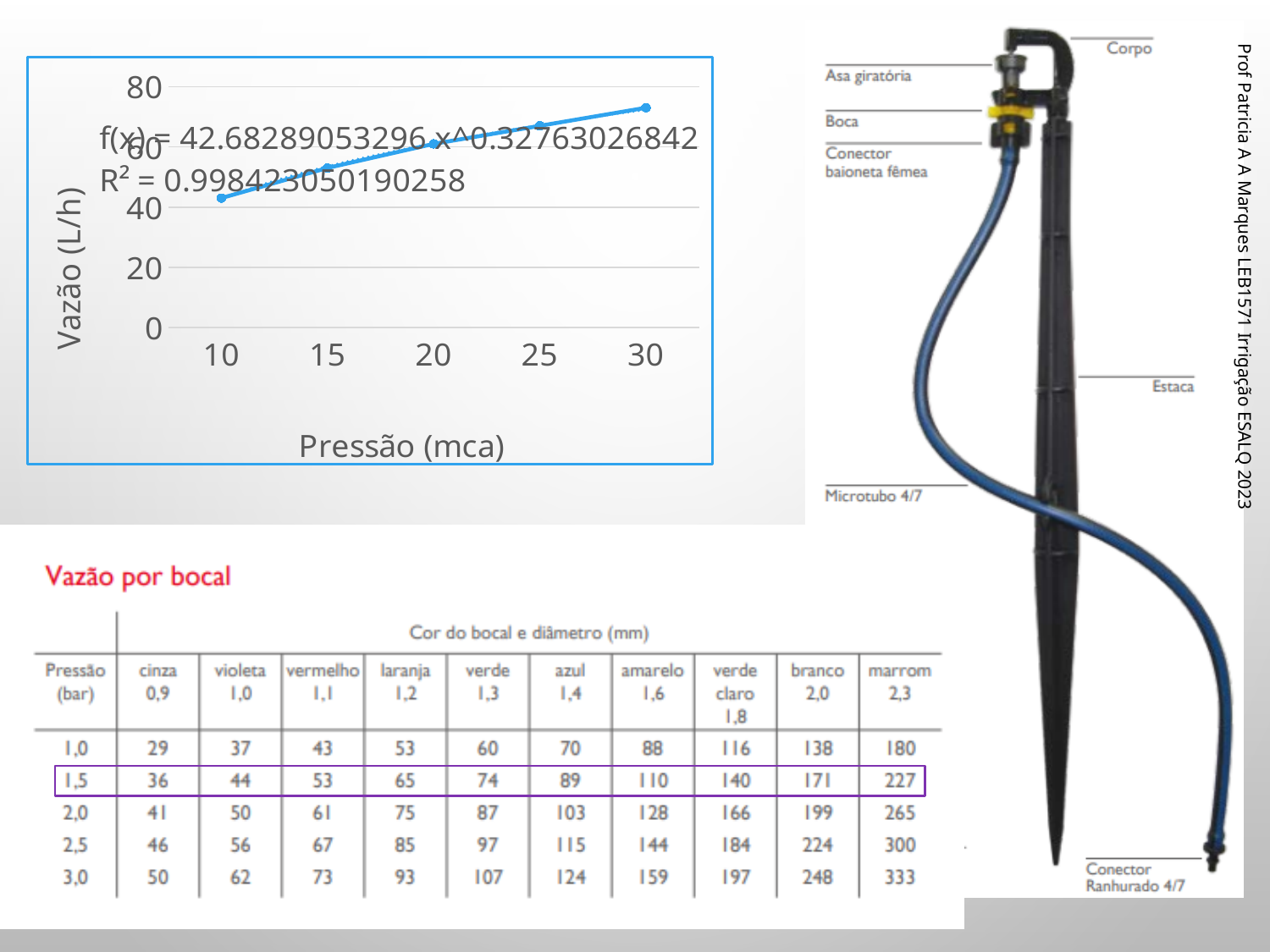
At which pressure (mca) is the plotted flow rate highest? 30 What is the title of the x axis of the chart? Pressão (mca) What R² value is shown for the trendline on the chart? 0.998423050190258 At which pressure (mca) is the plotted flow rate lowest? 10 Is the flow rate at 15 mca greater or less than 60 L/h? less What is the title of the y axis of the chart? Vazão (L/h) Is the flow rate at 10 mca greater or less than 40 L/h? greater Do the plotted values rise or fall as pressure increases along the x axis? rise How many data points are plotted on the chart? 5 Is the flow rate at 30 mca greater or less than 80 L/h? less Which has the larger flow rate on the chart: 30 mca or 10 mca? 30 mca